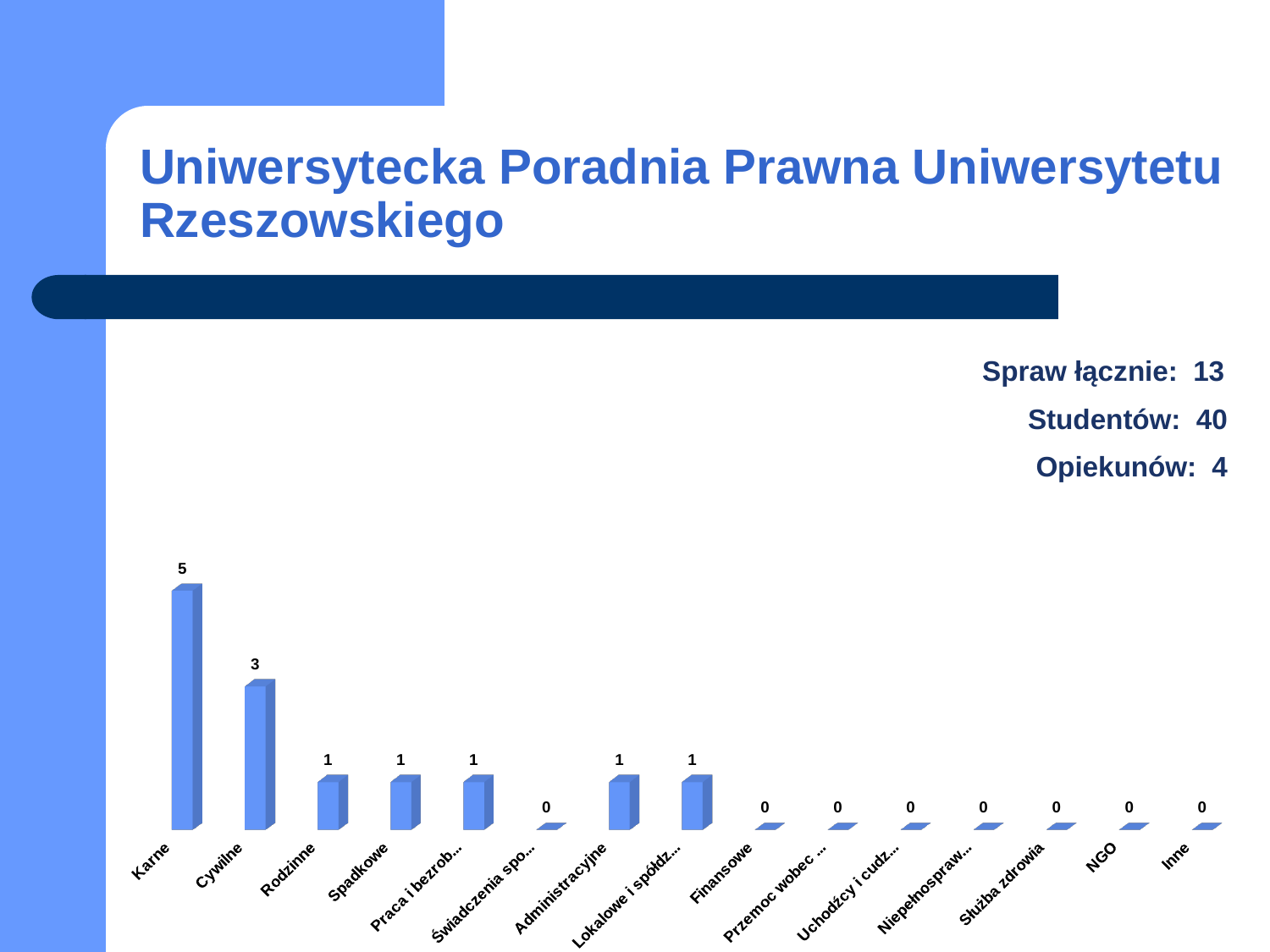
What is the value for Rodzinne? 1 What is the value for Cywilne? 3 What is the difference between the values for Karne and Cywilne? 2 What is the value for NGO? 0 What is the value for Karne? 5 Which is larger, the value for Cywilne or the value for Spadkowe? Cywilne What is the value for Administracyjne? 1 What is the difference between the values for Karne and Rodzinne? 4 What kind of chart is shown on the slide? Bar chart How many categories are shown on the x axis of the chart? 15 What is the value for Finansowe? 0 Which category has the highest value? Karne